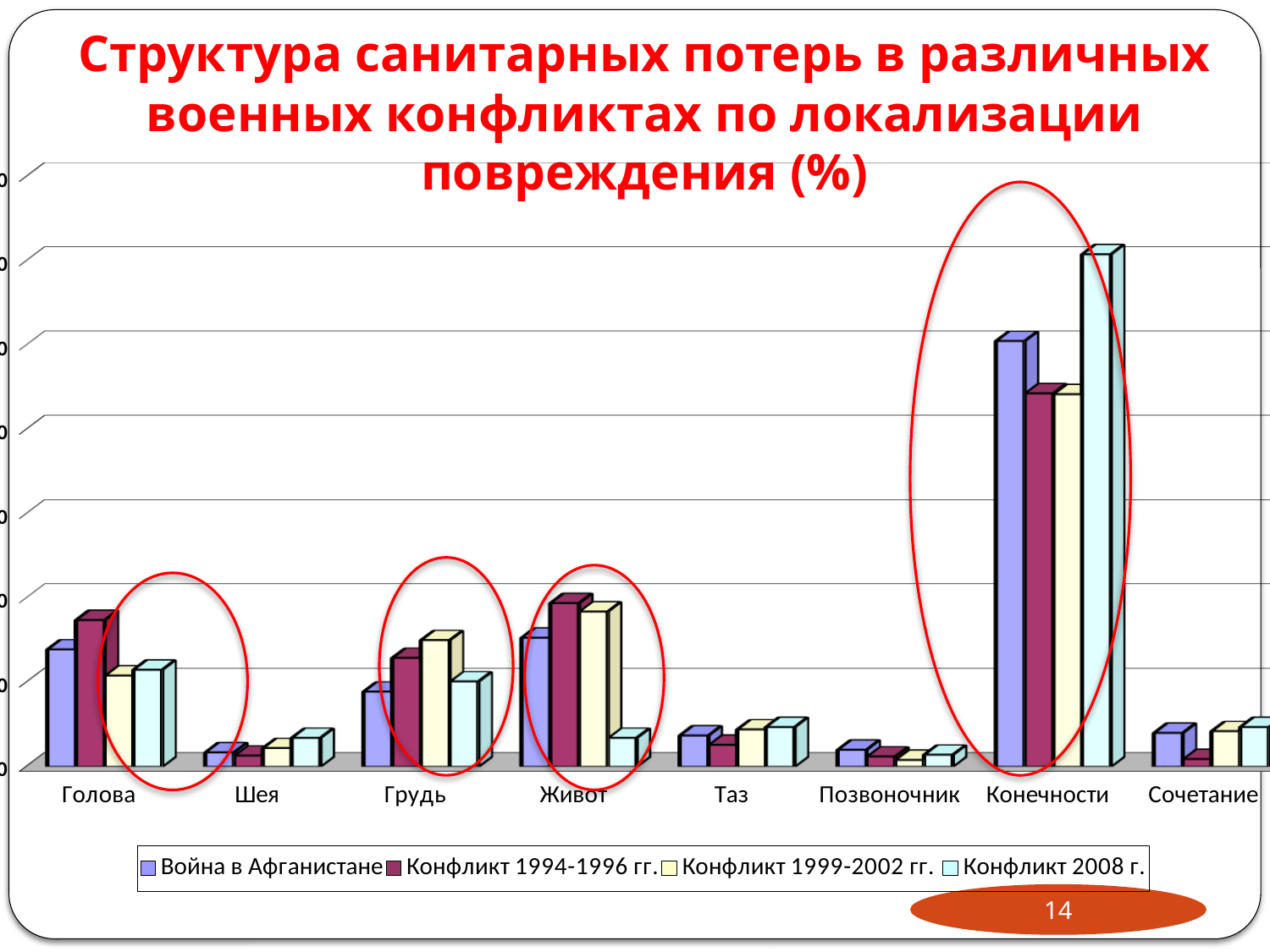
In the category Грудь, which is larger: the value for Конфликт 1999-2002 гг. or for Конфликт 2008 г.? Конфликт 1999-2002 гг. Within the category Живот, which series has the lowest value? Конфликт 2008 г. What is the title of the chart? Структура санитарных потерь в различных военных конфликтах по локализации повреждения (%) How many series does the legend list? 4 How many groups of bars are circled in red on the chart? 4 Within the category Конечности, which series has the highest value? Конфликт 2008 г. What kind of chart is shown on the slide? bar chart For the series Конфликт 2008 г., which category has the highest value? Конечности Within the category Грудь, which series has the highest value? Конфликт 1999-2002 гг. In the category Конечности, which is larger: the value for Война в Афганистане or for Конфликт 1994-1996 гг.? Война в Афганистане How many injury localization categories are shown on the x axis? 8